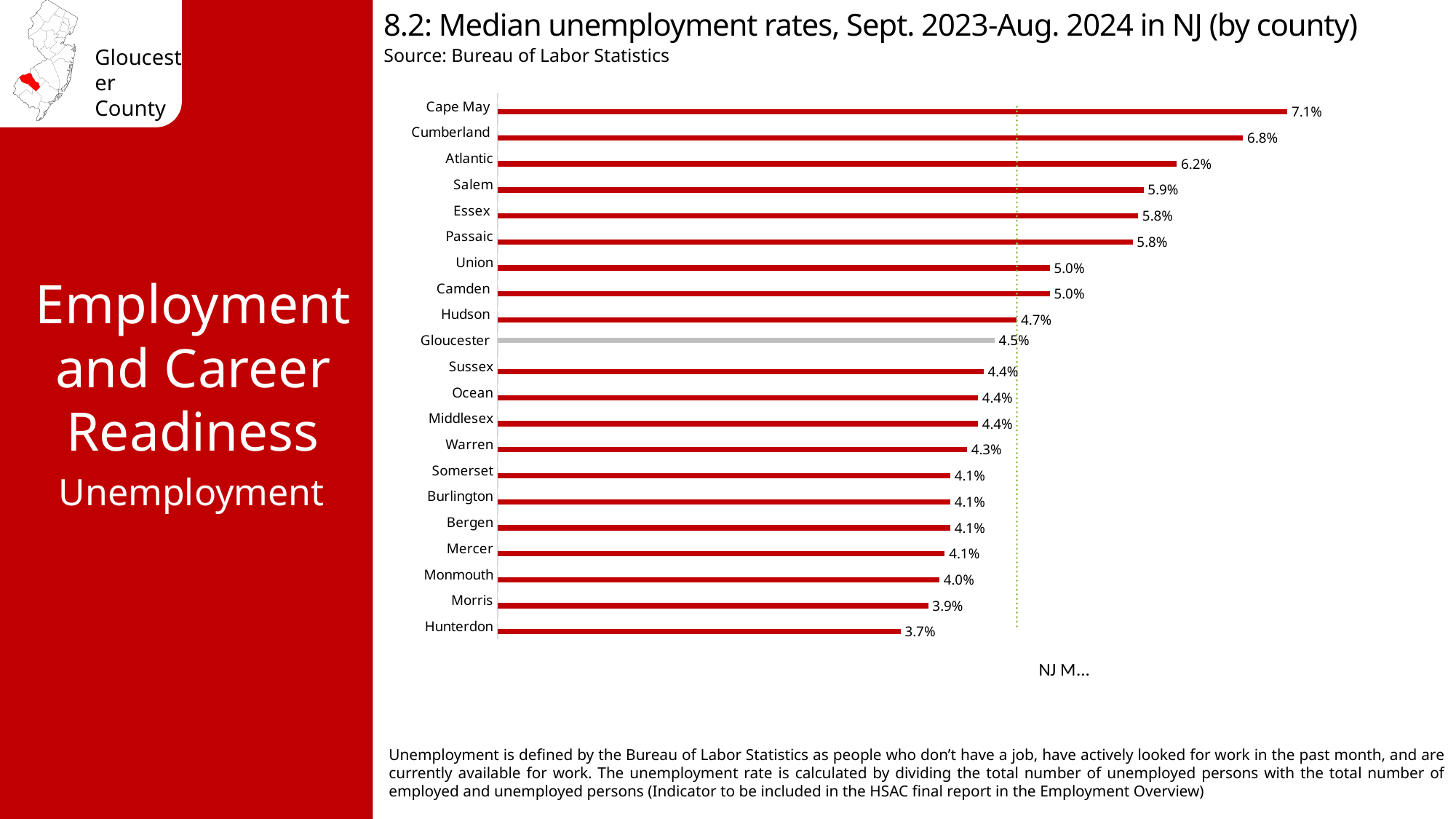
How many counties are shown in the chart? 21 What is the difference between the median unemployment rates of Cape May and Hunterdon? 3.4% What is the difference between the median unemployment rates of Cumberland and Gloucester? 2.3% Which county's bar is shown in grey instead of red? Gloucester Which county has a higher median unemployment rate, Atlantic or Salem? Atlantic What is the median unemployment rate for Hunterdon? 3.7% Which county has the lowest median unemployment rate? Hunterdon Which county has the highest median unemployment rate? Cape May What is the median unemployment rate for Gloucester County? 4.5% What type of chart is used on this slide? Bar chart Which county has a higher median unemployment rate, Gloucester or Morris? Gloucester What is the median unemployment rate for Cape May? 7.1%